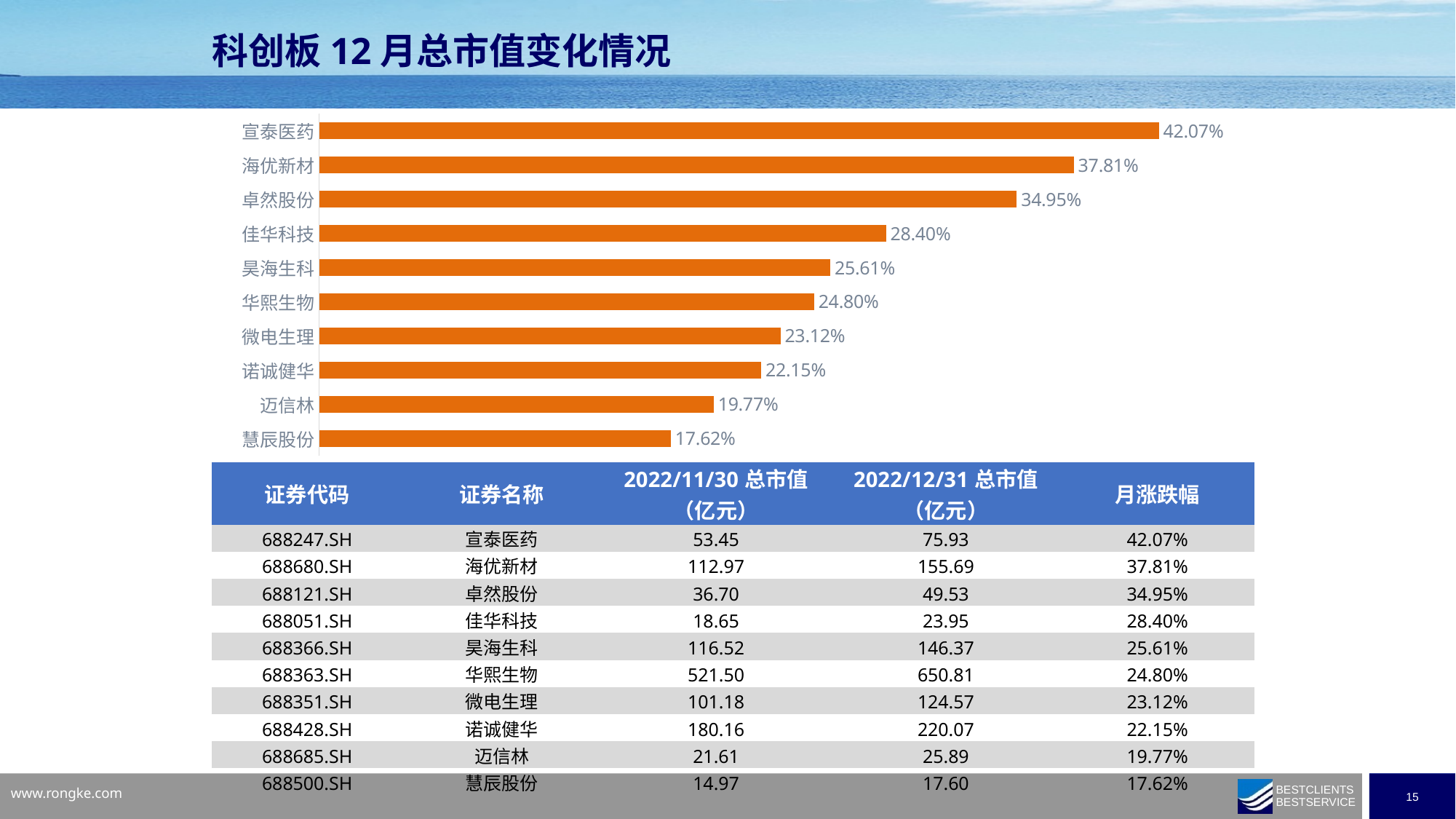
What is the value shown for 华熙生物 in the bar chart? 24.80% What is the difference between the values for 宣泰医药 and 海优新材 in the bar chart? 4.26% What is the value shown for 宣泰医药 in the bar chart? 42.07% Which has a larger value in the bar chart, 卓然股份 or 微电生理? 卓然股份 Which category has the lowest value in the bar chart? 慧辰股份 What is the difference between the values for 佳华科技 and 昊海生科 in the bar chart? 2.79% Which has a larger value in the bar chart, 诺诚健华 or 慧辰股份? 诺诚健华 How many categories are shown in the bar chart? 10 What colour are the bars in the chart? Orange What is the value shown for 迈信林 in the bar chart? 19.77% Which category has the highest value in the bar chart? 宣泰医药 What type of chart is shown on the slide? Bar chart